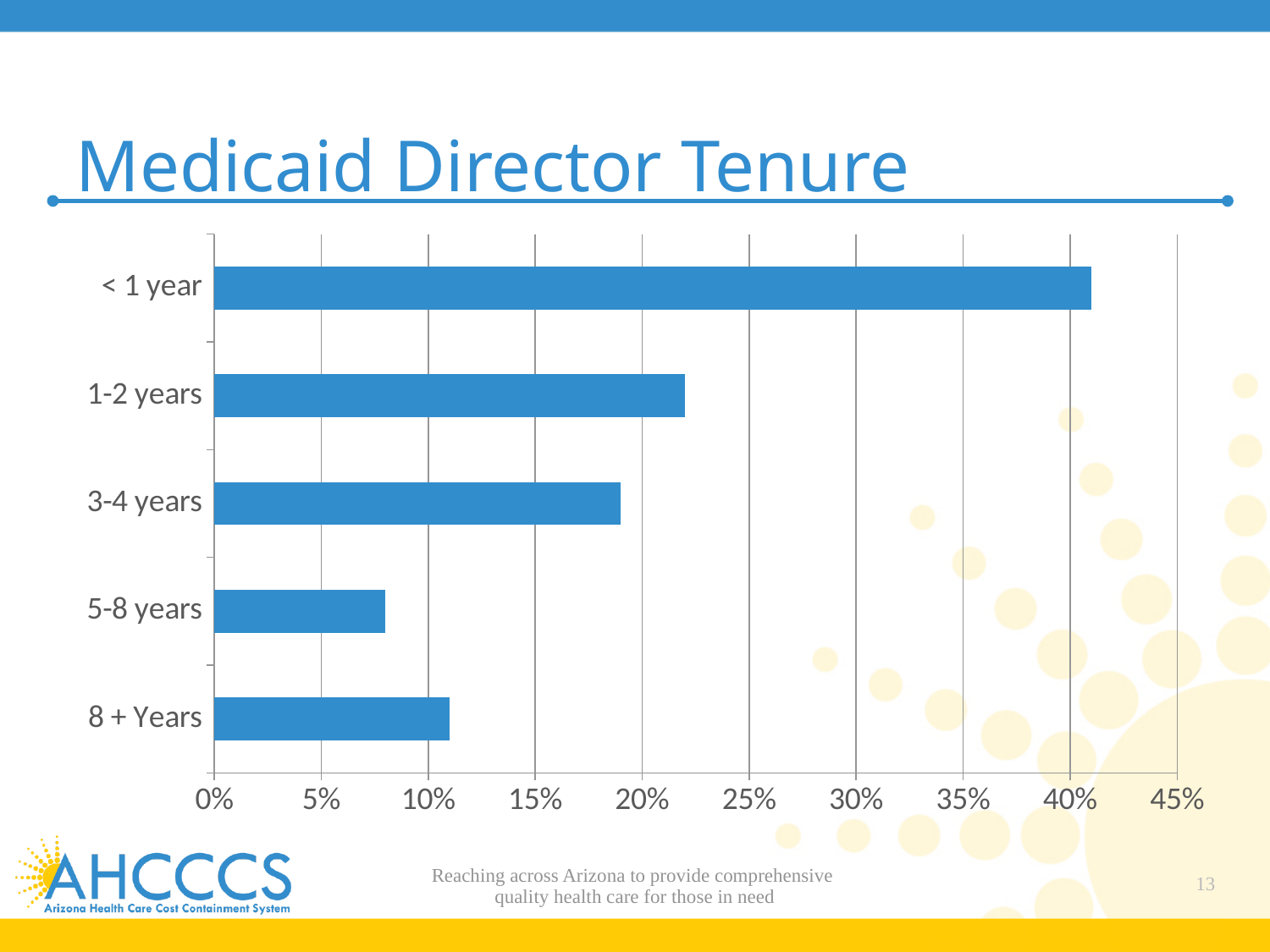
Which is larger, the value for 1-2 years or the value for 3-4 years? 1-2 years What kind of chart is shown on the slide? bar chart Is the value for 8 + Years greater or less than 15%? less What is the title of the chart? Medicaid Director Tenure Which is larger, the value for 5-8 years or the value for 8 + Years? 8 + Years How many tenure categories are shown in the chart? 5 Is the value for < 1 year greater or less than 35%? greater Which tenure category has the lowest value? 5-8 years Which tenure category has the highest value? < 1 year Is the value for 1-2 years greater or less than 20%? greater